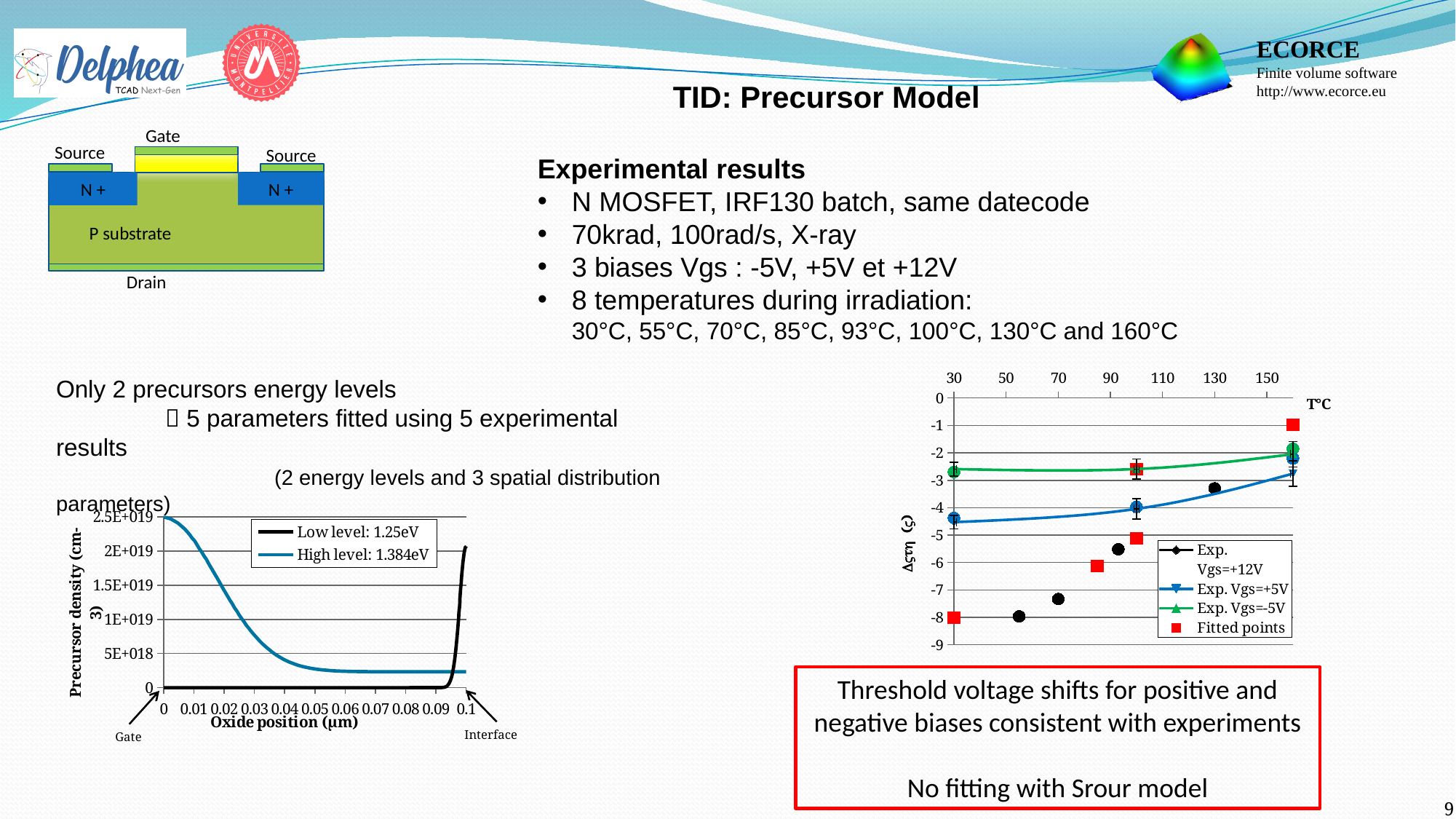
On the right chart (threshold voltage shift vs temperature), is the value for Exp. Vgs=+12V at 30°C greater or less than -7? less On the left chart (precursor density vs oxide position), how many series does the legend list? 2 On the left chart (precursor density vs oxide position), is the high level precursor density at oxide position 0.08 µm greater or less than 5E+018? less On the right chart (threshold voltage shift vs temperature), is the value for Exp. Vgs=-5V at 30°C greater or less than -3? greater On the left chart (precursor density vs oxide position), which series has the higher precursor density at oxide position 0.02 µm, the low level or the high level? High level On the right chart (threshold voltage shift vs temperature), how many series does the legend list? 4 On the left chart (precursor density vs oxide position), what energy is given in the legend for the high level series? 1.384eV On the left chart (precursor density vs oxide position), what kind of chart is it? line chart On the left chart (precursor density vs oxide position), what energy is given in the legend for the low level series? 1.25eV On the right chart (threshold voltage shift vs temperature), which series has the lowest (most negative) values at 30°C? Exp. Vgs=+12V On the left chart (precursor density vs oxide position), does the high level series rise or fall as oxide position increases from 0 to 0.05 µm? fall On the right chart (threshold voltage shift vs temperature), does the Exp. Vgs=+12V series rise or fall as temperature increases from 30°C to 160°C? rise